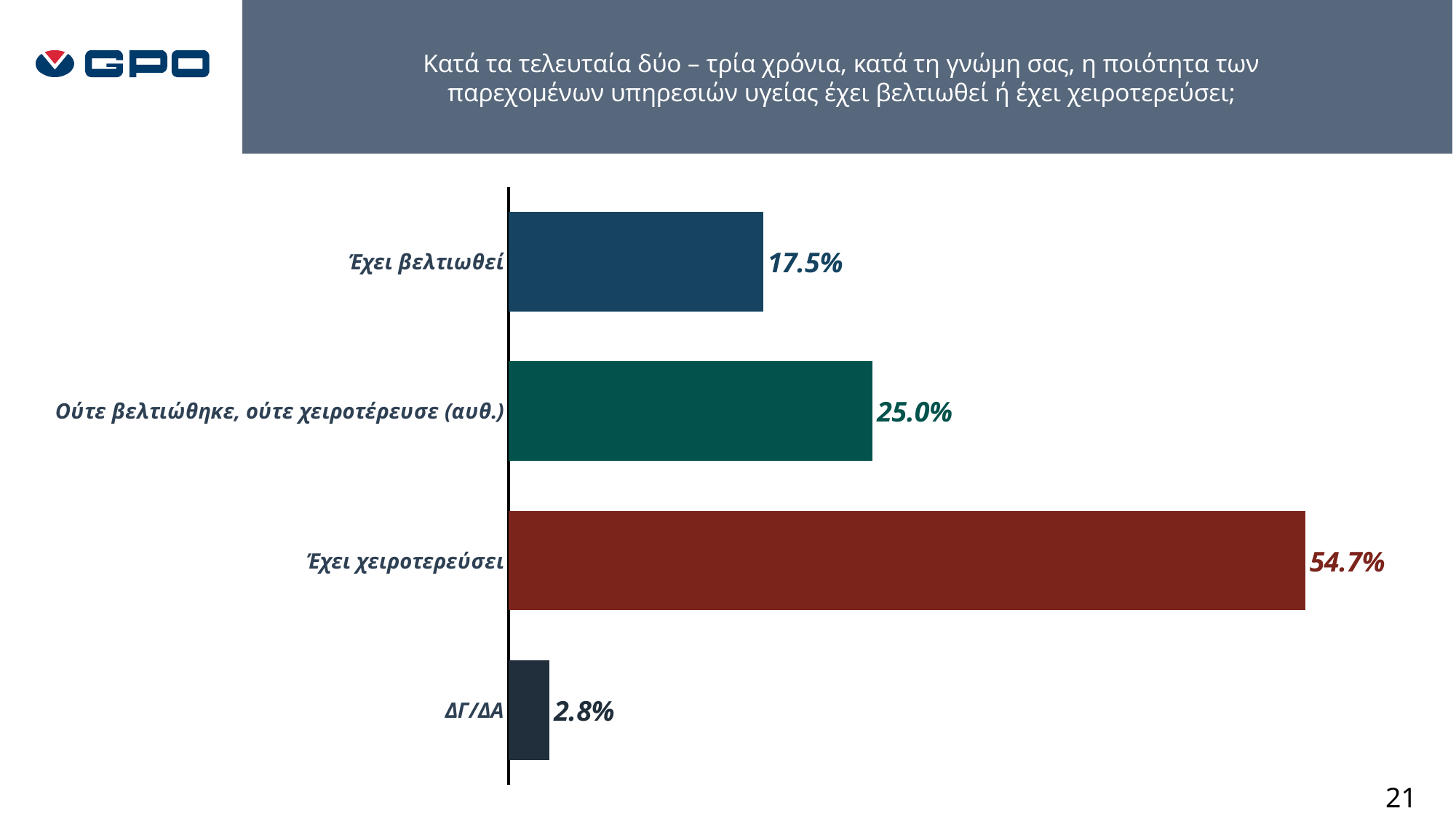
What is the value for Έχει χειροτερεύσει? 54.7% Which category has the lowest value? ΔΓ/ΔΑ Which category has the highest value? Έχει χειροτερεύσει What is the value for Έχει βελτιωθεί? 17.5% What colour is the bar for Έχει χειροτερεύσει? Dark red Which is larger, the value for Έχει βελτιωθεί or the value for Ούτε βελτιώθηκε, ούτε χειροτέρευσε (αυθ.)? Ούτε βελτιώθηκε, ούτε χειροτέρευσε (αυθ.) What kind of chart is shown on the slide? Bar chart What is the value for Ούτε βελτιώθηκε, ούτε χειροτέρευσε (αυθ.)? 25.0% What is the difference between the values for Έχει χειροτερεύσει and Έχει βελτιωθεί? 37.2% What is the difference between the values for Ούτε βελτιώθηκε, ούτε χειροτέρευσε (αυθ.) and Έχει βελτιωθεί? 7.5% What is the value for ΔΓ/ΔΑ? 2.8% How many categories are shown in the chart? 4